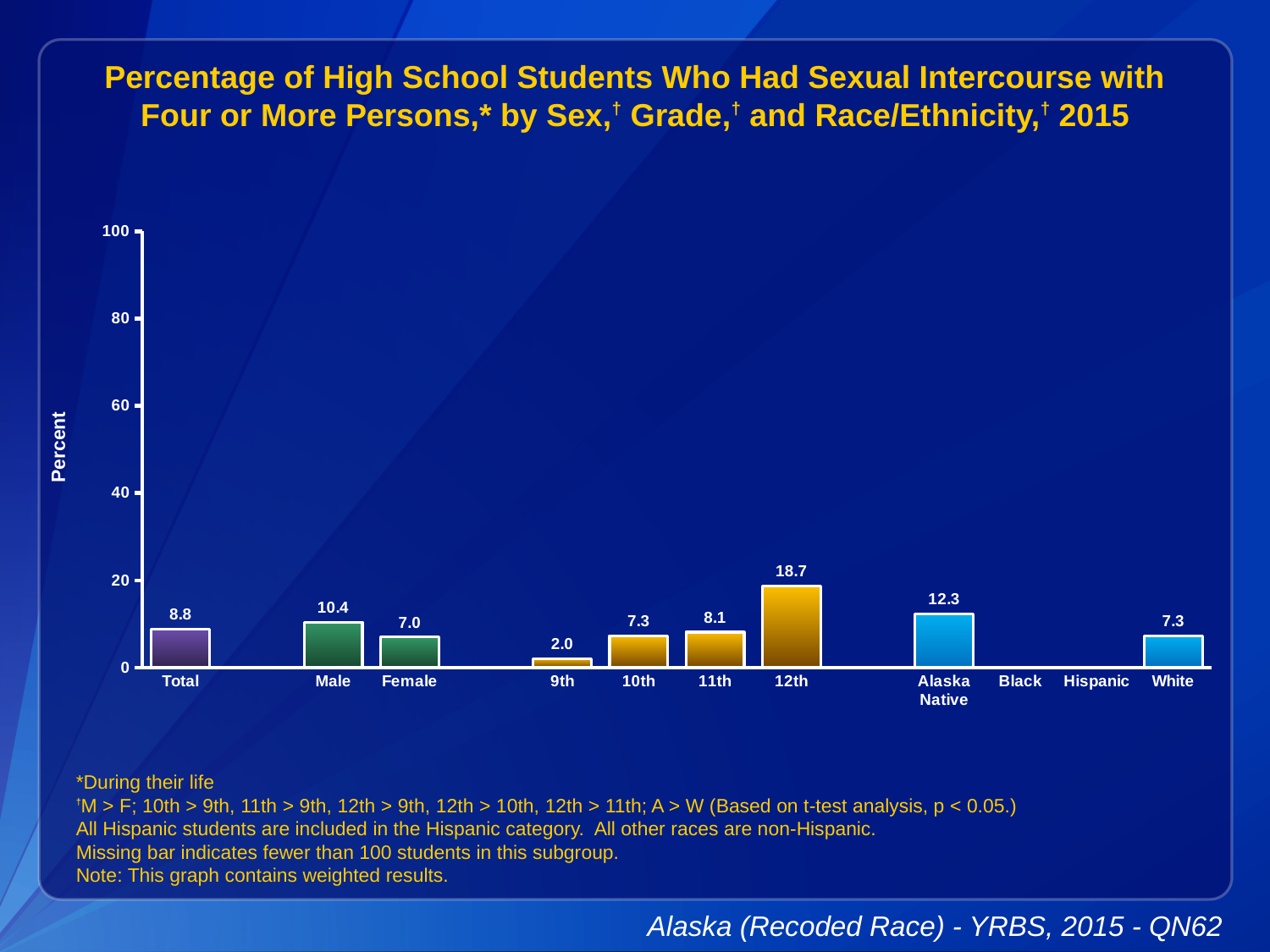
Is the value for 12th grade greater or less than 20? less Do the values rise or fall from 9th grade to 12th grade? rise What kind of chart is shown on the slide? bar chart What is the value for 9th grade? 2.0 What is the value for Total? 8.8 Which category has the highest value? 12th What is the value for Male? 10.4 What is the difference between the 12th grade and 11th grade values? 10.6 What is the value for Alaska Native? 12.3 Which is larger, the value for Alaska Native or the value for White? Alaska Native Which category with a bar has the lowest value? 9th What is the difference between the Male and Female values? 3.4